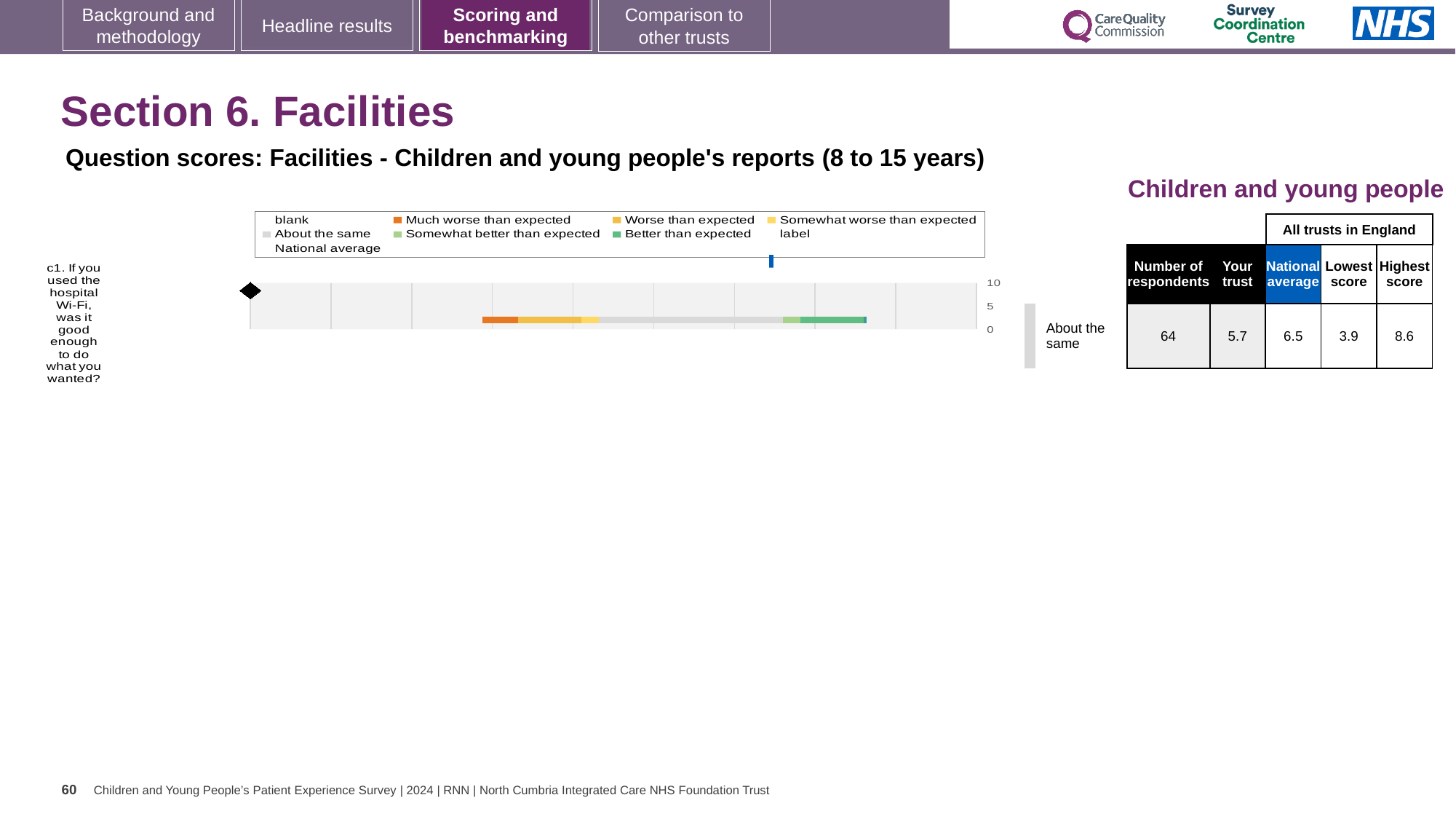
What is the 'Your trust' score for question c1 about the hospital Wi-Fi? 5.7 What is the lowest score among all trusts in England for question c1? 3.9 What kind of chart is used to show the question score for c1 on this slide? bar chart What is the highest score among all trusts in England for question c1? 8.6 For question c1, how much higher is the national average than the 'Your trust' score? 0.8 For question c1, which is larger: the 'Your trust' score or the national average? National average For question c1, what is the difference between the highest score and the lowest score among all trusts in England? 4.7 Which legend entry is shown in orange in the chart? Much worse than expected What benchmark category is shown next to the chart for question c1? About the same How many survey questions are plotted in the chart on this slide? 1 What is the number of respondents for question c1 about the hospital Wi-Fi? 64 What is the national average score for question c1 about the hospital Wi-Fi? 6.5